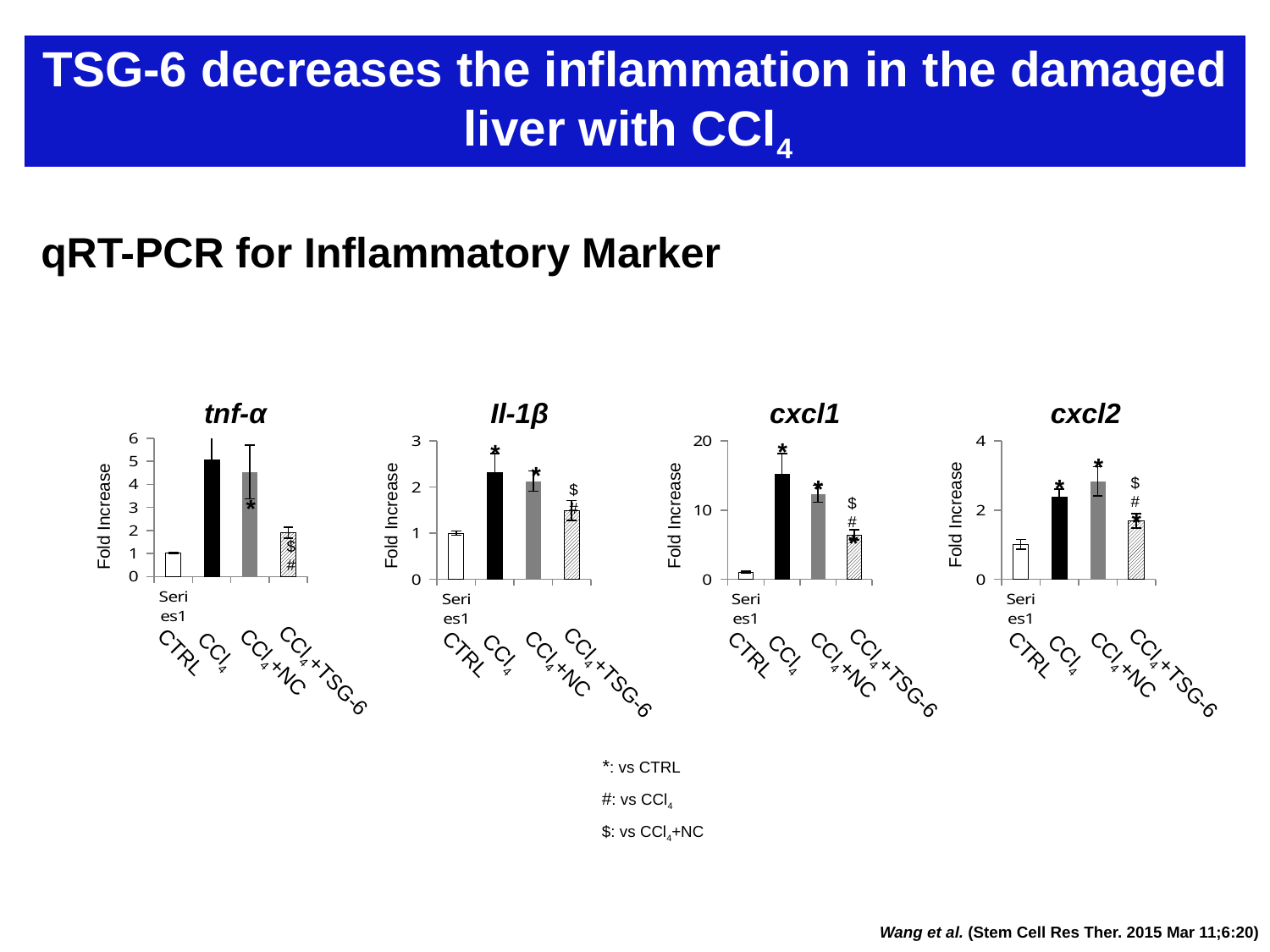
In the Il-1β chart, is the value for CCl4 greater or less than 2? greater In the cxcl1 chart, which is larger, the value for CCl4+NC or the value for CCl4+TSG-6? CCl4+NC What is the y-axis title of the Il-1β chart? Fold Increase In the cxcl1 chart, is the value for CCl4 greater or less than 10? greater In the tnf-α chart, is the value for CCl4+TSG-6 greater or less than 3? less In the cxcl2 chart, which is larger, the value for CCl4+TSG-6 or the value for CTRL? CCl4+TSG-6 In the tnf-α chart, which category has the lowest value? CTRL What kind of chart is the tnf-α chart? bar chart How many categories are plotted on the x axis of the cxcl1 chart? 4 In the cxcl1 chart, which category has the highest value? CCl4 In the cxcl2 chart, which category has the highest value? CCl4+NC